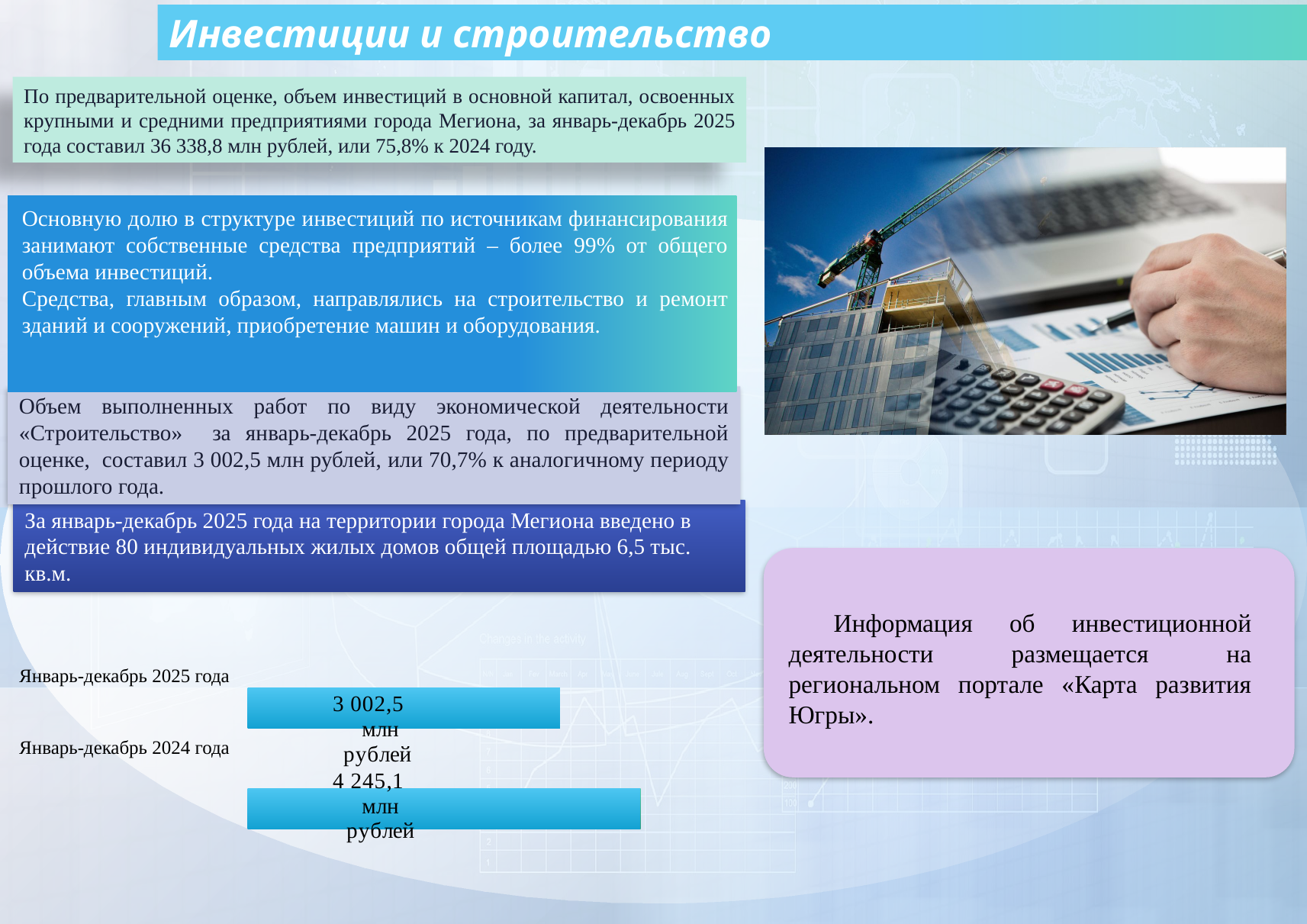
Which period has the higher value in the bar chart? Январь-декабрь 2024 года What type of chart is shown at the bottom left of the slide? bar chart How many categories (periods) are shown in the bar chart? 2 Did the value fall or rise from Январь-декабрь 2024 года to Январь-декабрь 2025 года according to the bar chart? fall Is the bar for Январь-декабрь 2025 года longer or shorter than the bar for Январь-декабрь 2024 года? shorter What colour are the bars in the chart? blue Which period has the lower value in the bar chart? Январь-декабрь 2025 года What is the value shown for Январь-декабрь 2024 года in the bar chart? 4 245,1 млн рублей What is the value shown for Январь-декабрь 2025 года in the bar chart? 3 002,5 млн рублей Are the bars in the chart oriented horizontally or vertically? horizontally By how much does the value for Январь-декабрь 2024 года exceed the value for Январь-декабрь 2025 года in the bar chart? 1 242,6 млн рублей